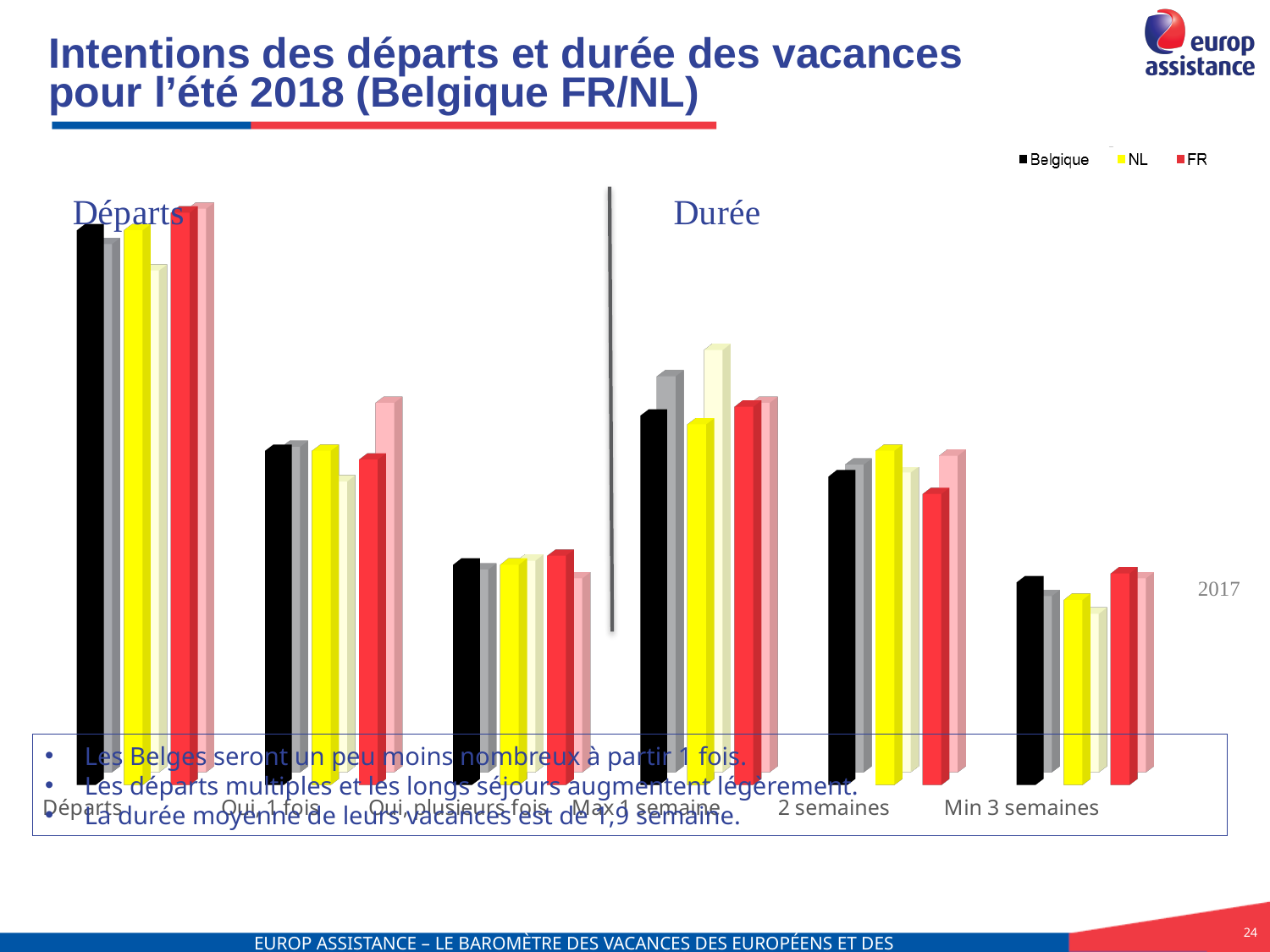
Which colour represents the NL series in the chart legend? yellow Is the Belgique bar taller for 'Départs' or for 'Oui plusieurs fois'? Départs Within the 'Min 3 semaines' category, which series has the shortest bar? NL Do the bars rise or fall moving from 'Max 1 semaine' to 'Min 3 semaines'? fall In the 'Min 3 semaines' category, is the FR bar or the NL bar taller? FR Which category has the shortest bars in the chart? Min 3 semaines How many series does the chart legend list? 3 What is the title of the slide containing the chart? Intentions des départs et durée des vacances pour l'été 2018 (Belgique FR/NL) How many categories are shown along the x axis of the chart? 6 Which category has the tallest bars in the chart? Départs What kind of chart is shown on the slide? bar chart Within the '2 semaines' category, which series has the tallest bar? NL